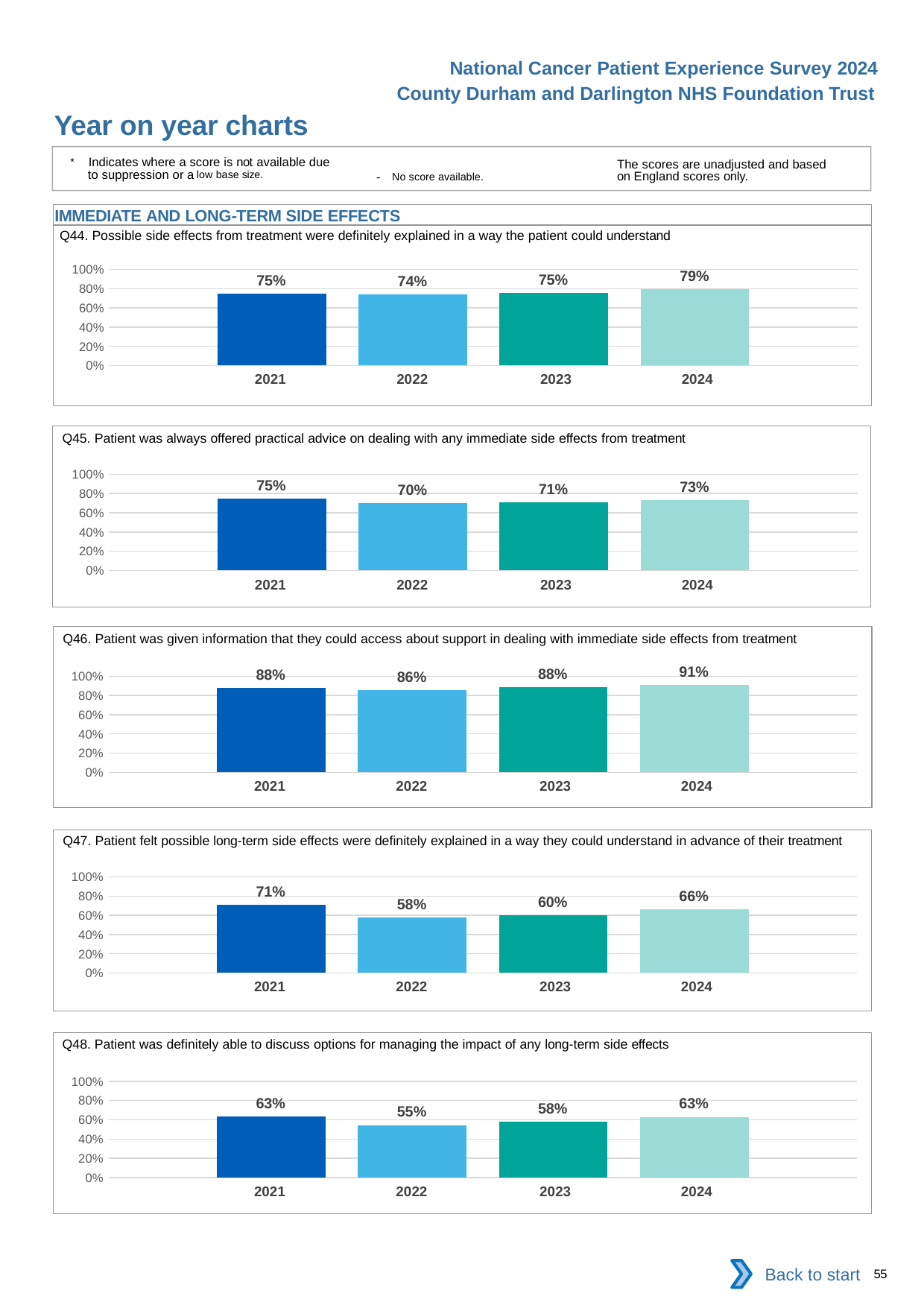
In the Q45 chart, which year has the lowest value? 2022 In the Q46 chart, which year has the highest value? 2024 In the Q48 chart, do the values rise or fall from 2022 to 2024? rise How many years are shown in the Q44 chart? 4 What type of chart is the Q45 chart? bar chart In the Q47 chart, which year has the highest value? 2021 In the Q48 chart, what is the value for 2022? 55% In the Q44 chart, what is the value for 2024? 79% In the Q47 chart, what is the difference between the 2021 and 2022 values? 13% In the Q45 chart, what is the value for 2021? 75% In the Q47 chart, is the value for 2023 larger or smaller than the value for 2024? smaller In the Q46 chart, what is the difference between the 2024 and 2022 values? 5%